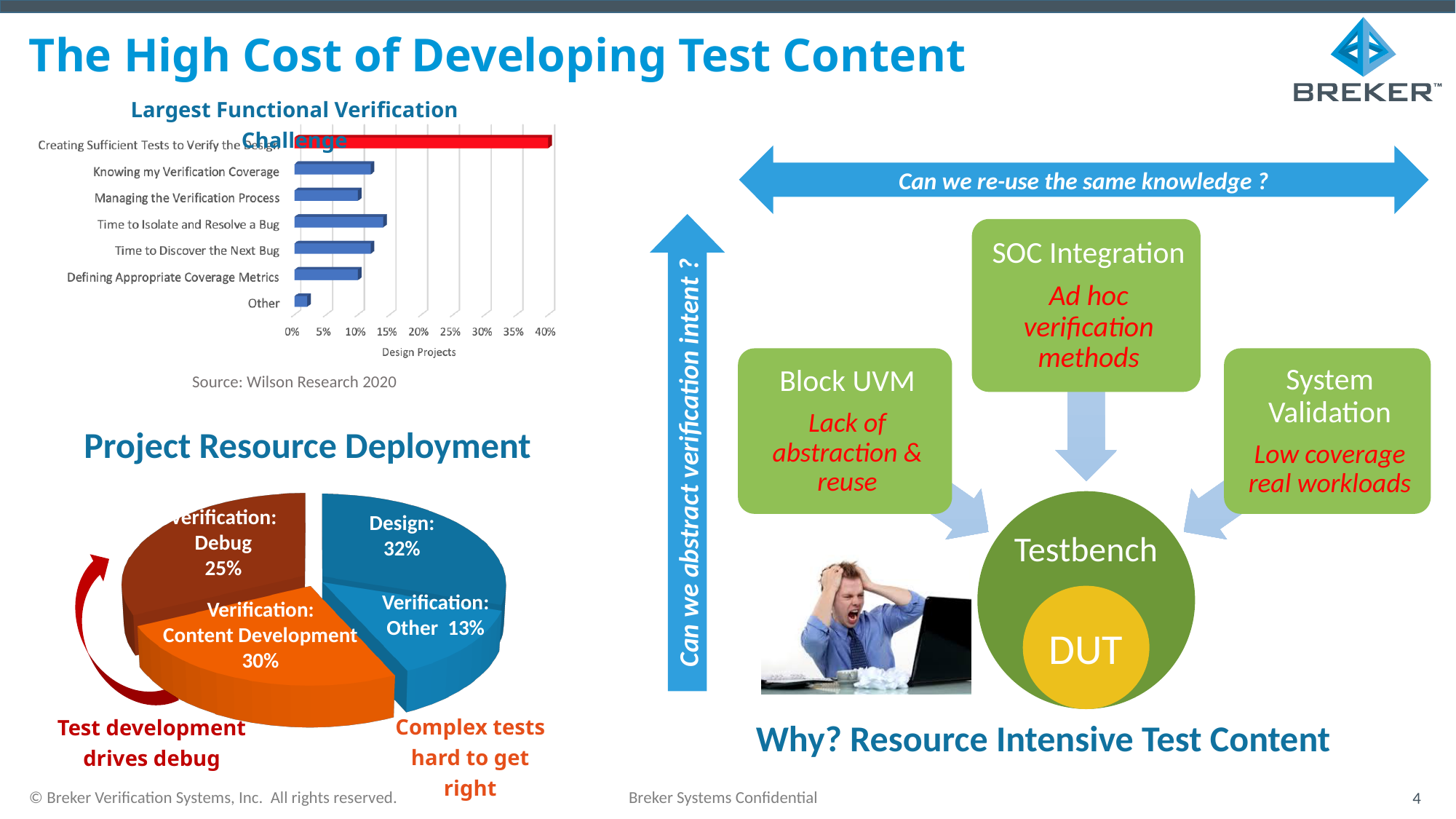
In the Largest Functional Verification Challenge chart, is the value for Other greater or less than 5%? less In the Largest Functional Verification Challenge chart, which category has the longest bar? Creating Sufficient Tests to Verify the Design In the Project Resource Deployment chart, which slice is the smallest? Verification: Other In the Largest Functional Verification Challenge chart, is the value for Time to Isolate and Resolve a Bug greater or less than 20%? less How many categories are shown in the Largest Functional Verification Challenge chart? 7 What kind of chart is the Largest Functional Verification Challenge chart? Bar chart In the Project Resource Deployment chart, what is the difference between Design and Verification: Debug? 7% In the Project Resource Deployment chart, what share is Verification: Content Development? 30% In the Largest Functional Verification Challenge chart, is the value for Creating Sufficient Tests to Verify the Design greater or less than 35%? greater What is the x-axis label of the Largest Functional Verification Challenge chart? Design Projects In the Project Resource Deployment chart, what share is Design? 32% In the Largest Functional Verification Challenge chart, which category has the shortest bar? Other